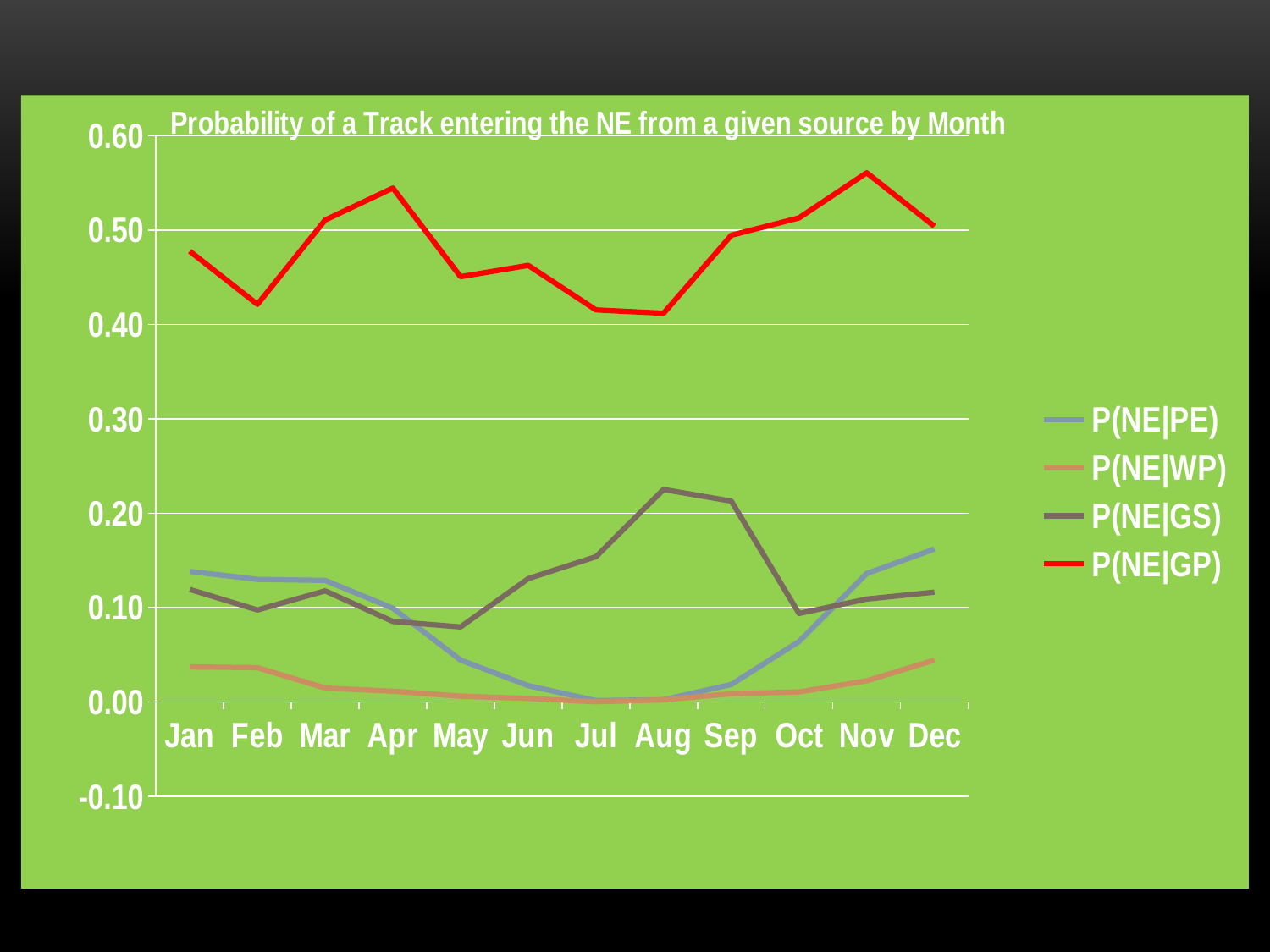
Is the value of P(NE|GP) in Aug greater or less than 0.50? less What is the title of the chart? Probability of a Track entering the NE from a given source by Month Does P(NE|PE) rise or fall from Jan to Jul? fall In which month does P(NE|PE) reach its highest value? Dec What kind of chart is shown on the slide? line chart In Sep, which is larger: P(NE|GS) or P(NE|PE)? P(NE|GS) Is the value of P(NE|GP) in Nov greater or less than 0.50? greater Which series is drawn in red? P(NE|GP) Which series has the highest values across all months? P(NE|GP) How many series does the legend list? 4 In which month does P(NE|GS) reach its highest value? Aug How many months are plotted along the x axis? 12